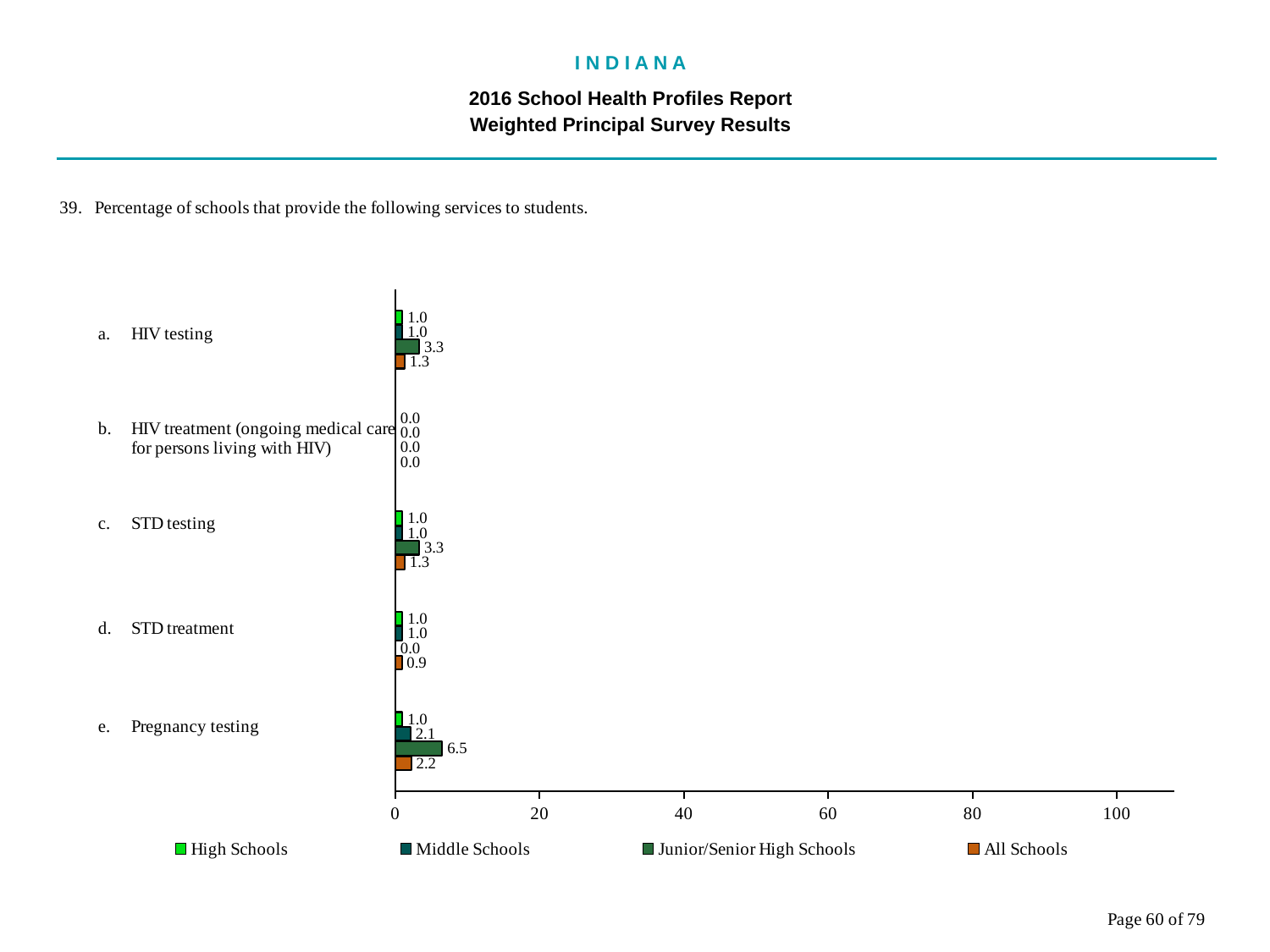
What is the difference between the Junior/Senior High Schools value and the All Schools value for pregnancy testing? 4.3 Is the value for Junior/Senior High Schools for pregnancy testing greater or less than 20? less What is the value for All Schools for HIV testing? 1.3 Which service has a value of 0.0 for all four school types? HIV treatment (ongoing medical care for persons living with HIV) What is the value for Middle Schools for pregnancy testing? 2.1 What percentage of Junior/Senior High Schools provide pregnancy testing? 6.5 How many series does the legend list? 4 How many services are listed on the chart? 5 For STD testing, which is larger: the Junior/Senior High Schools value or the Middle Schools value? Junior/Senior High Schools What is the value for Junior/Senior High Schools for STD treatment? 0.0 Which service has the highest value for Junior/Senior High Schools? Pregnancy testing What kind of chart is shown on the slide? Bar chart